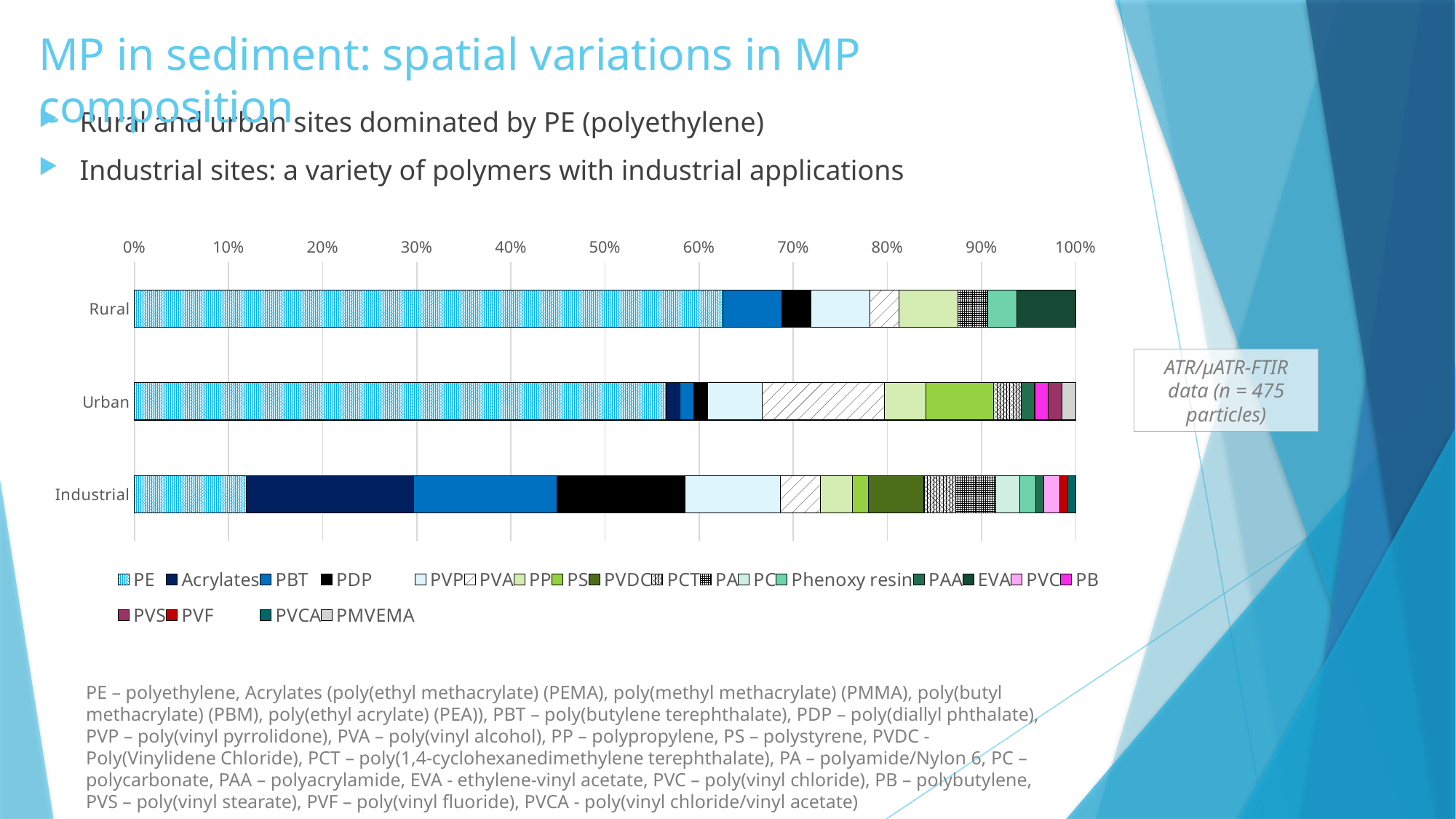
Is the share of PE at the Urban site greater or less than 50%? greater Is the share of PE at the Rural site greater or less than 50%? greater Which site has the largest share of PE? Rural Is the share of PE at the Industrial site greater or less than 20%? less What is the first series listed in the chart legend? PE According to the annotation next to the chart, how many particles does the ATR/µATR-FTIR data include? 475 How many series does the chart legend list? 21 Which site has a larger share of PBT, Rural or Industrial? Industrial How many site categories are plotted on the chart? 3 What kind of chart is shown on the slide? Stacked bar chart Which site has the smallest share of PE? Industrial